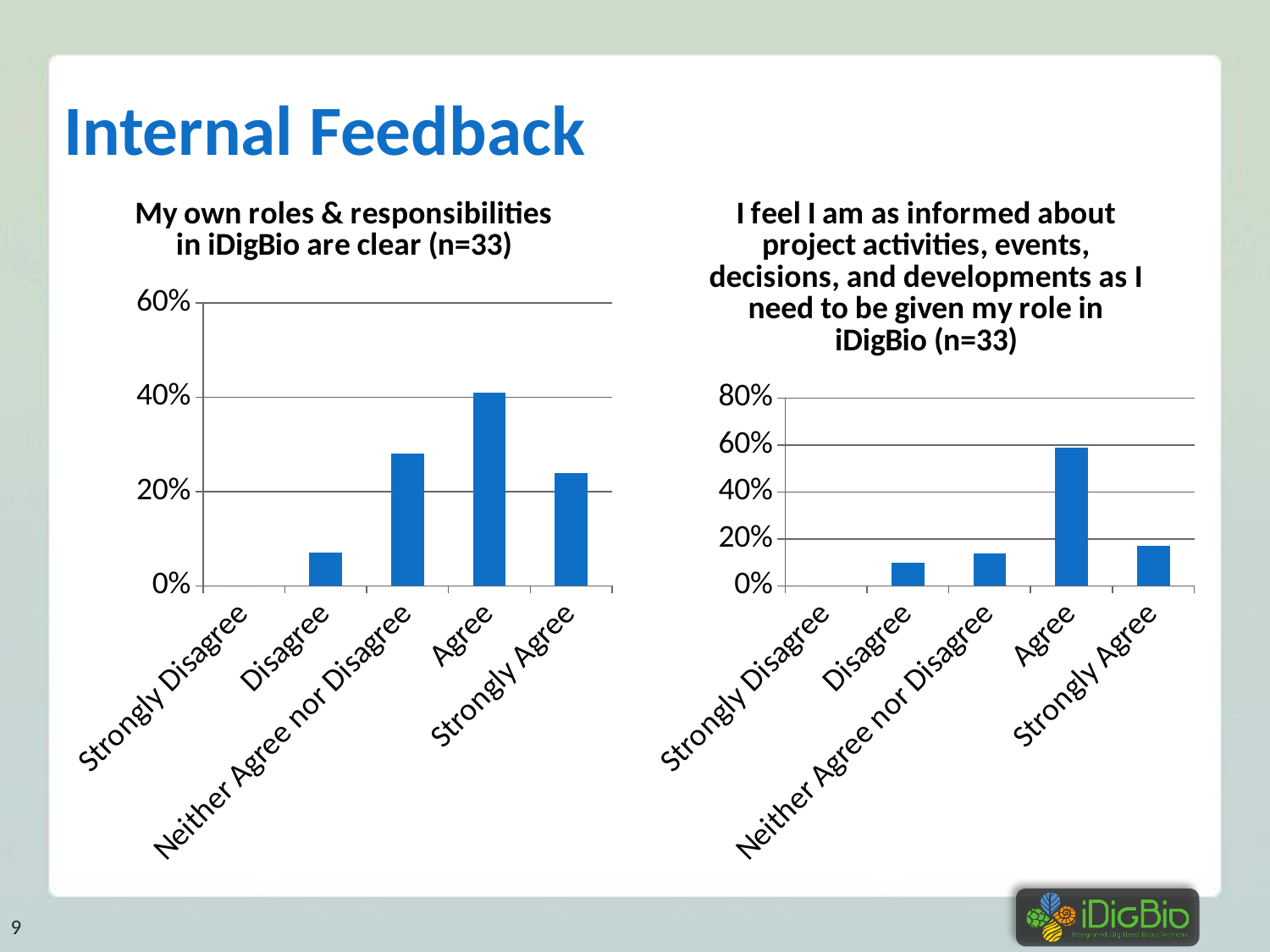
In the left chart, 'My own roles & responsibilities in iDigBio are clear', which category has the highest value? Agree What is the highest value shown on the y axis of the right chart, 'I feel I am as informed about project activities...'? 80% What kind of chart is the left chart, 'My own roles & responsibilities in iDigBio are clear'? bar chart In the left chart, 'My own roles & responsibilities in iDigBio are clear', is the value for Neither Agree nor Disagree greater or less than 20%? greater In the right chart, 'I feel I am as informed about project activities...', which category has the highest value? Agree In the right chart, 'I feel I am as informed about project activities...', which is larger: the value for Agree or the value for Strongly Agree? Agree In the right chart, 'I feel I am as informed about project activities...', is the value for Strongly Agree greater or less than 20%? less In the left chart, 'My own roles & responsibilities in iDigBio are clear', is the value for Disagree greater or less than 20%? less In the left chart, 'My own roles & responsibilities in iDigBio are clear', which is larger: the value for Agree or the value for Neither Agree nor Disagree? Agree How many response categories are shown on the x axis of the right chart, 'I feel I am as informed about project activities...'? 5 In the left chart, 'My own roles & responsibilities in iDigBio are clear', which category has the lowest value? Strongly Disagree